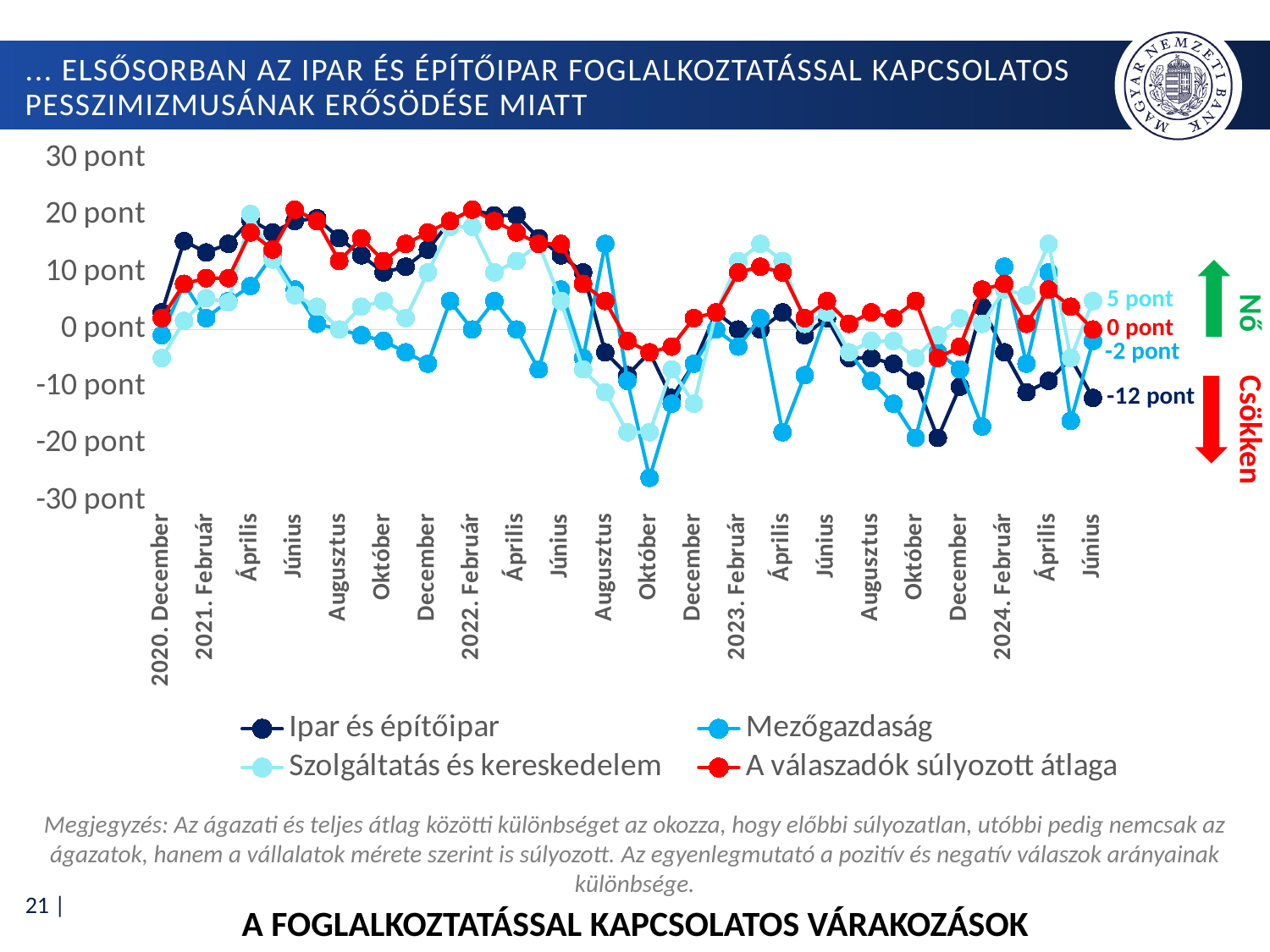
What kind of chart is shown on the slide? line chart What is the difference between the last values of Szolgáltatás és kereskedelem and Ipar és építőipar? 17 pont How many series does the legend list? 4 What is the title of the chart shown at the bottom of the slide? A foglalkoztatással kapcsolatos várakozások What is the value for Ipar és építőipar at the last point (Június 2024)? -12 pont Which series has the lowest value at the last point (Június 2024)? Ipar és építőipar Is the value for Mezőgazdaság in Október 2022 greater or less than -20 pont? less What is the value for Szolgáltatás és kereskedelem at the last point (Június 2024)? 5 pont Which series has the highest value at the last point (Június 2024)? Szolgáltatás és kereskedelem Does A válaszadók súlyozott átlaga rise or fall between 2022. Február and Október 2022? fall What is the value for A válaszadók súlyozott átlaga at the last point (Június 2024)? 0 pont What is the value for Mezőgazdaság at the last point (Június 2024)? -2 pont